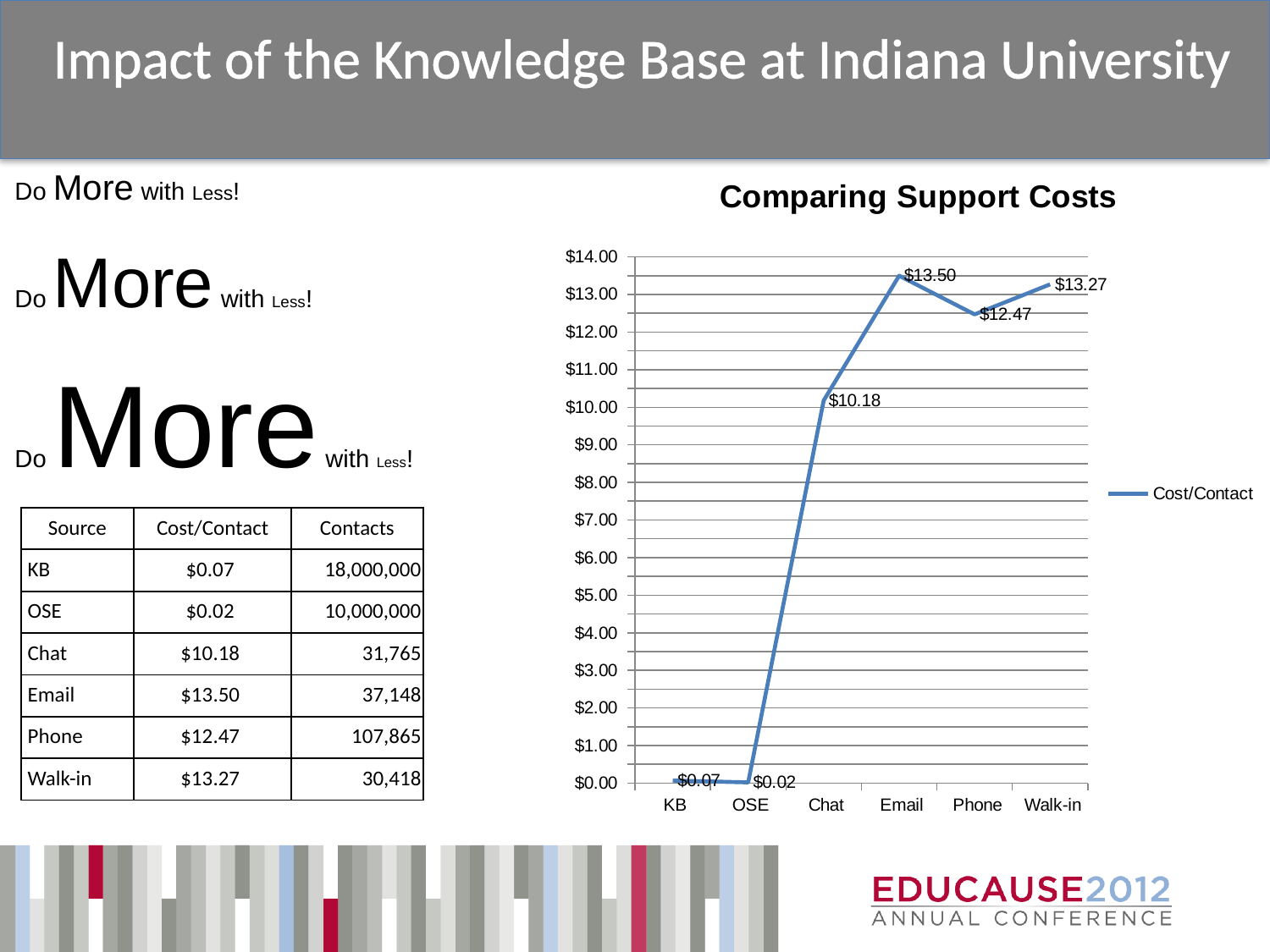
What is the difference in Cost/Contact between Email and Phone? $1.03 Which category has the lowest Cost/Contact in the chart? OSE Is the Cost/Contact for Chat greater or less than $10.00? greater What is the Cost/Contact value for OSE in the chart? $0.02 What is the Cost/Contact value for Chat in the Comparing Support Costs chart? $10.18 Which has a higher Cost/Contact, Walk-in or Phone? Walk-in How many series does the chart legend list? 1 Which category has the highest Cost/Contact in the chart? Email How many categories are shown on the x axis of the chart? 6 What kind of chart is shown on the slide? line chart What is the title of the chart? Comparing Support Costs What is the Cost/Contact value for Phone in the chart? $12.47